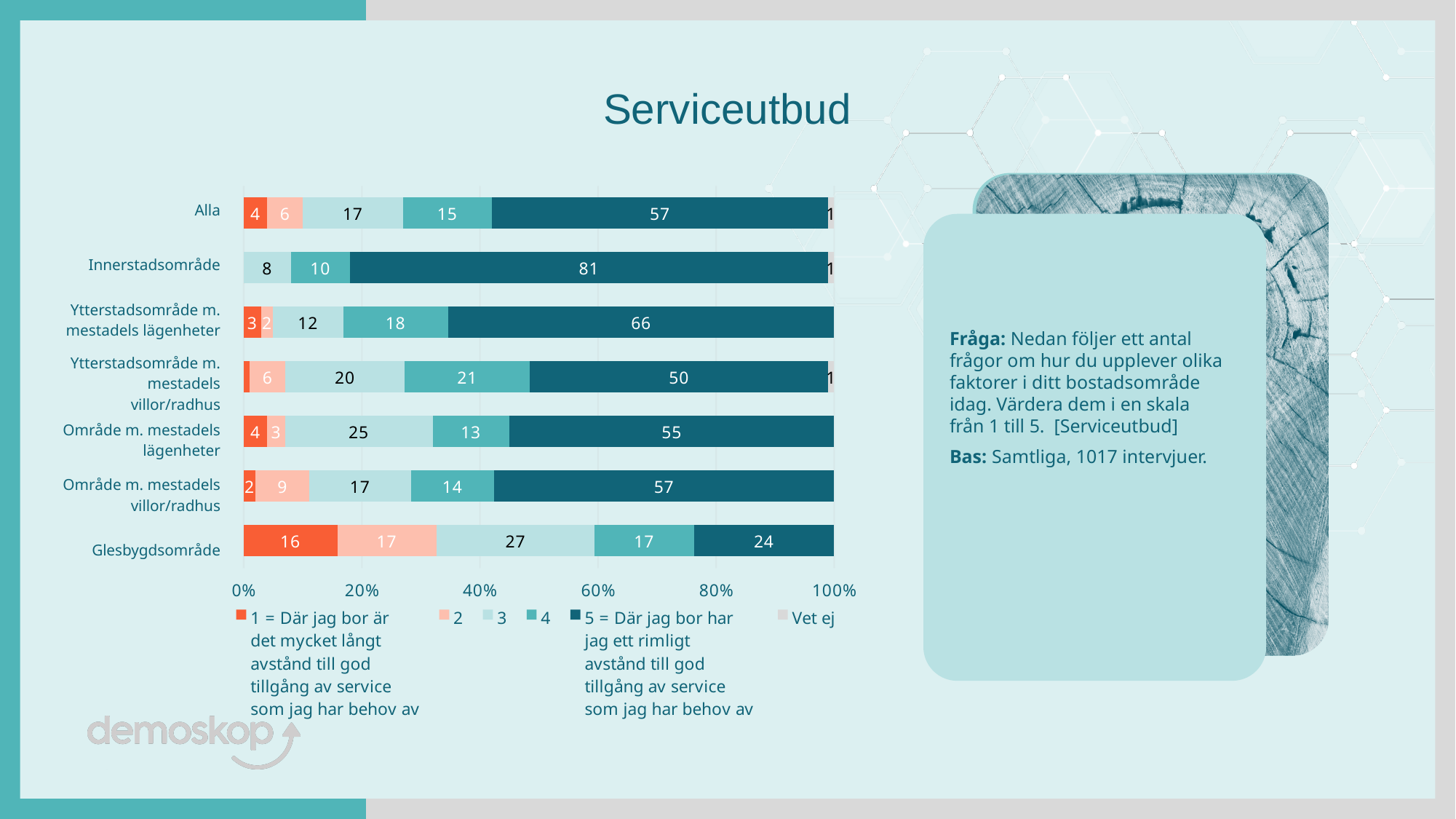
What type of chart is shown on the slide? Stacked bar chart What is the difference between the series 5 values for Innerstadsområde and Glesbygdsområde? 57 Which category has the lowest value for series 5? Glesbygdsområde How many categories (area types) are shown on the chart? 7 What is the value for series 2 in the Område m. mestadels villor/radhus bar? 9 What is the title of the chart? Serviceutbud What is the value for series 5 in the Innerstadsområde bar? 81 What is the value for series 3 in the Glesbygdsområde bar? 27 What is the value for series 4 in the Alla bar? 15 Which is larger: the series 1 value for Glesbygdsområde or the series 1 value for Alla? Glesbygdsområde How many series does the legend list? 6 Which category has the highest value for series 5? Innerstadsområde